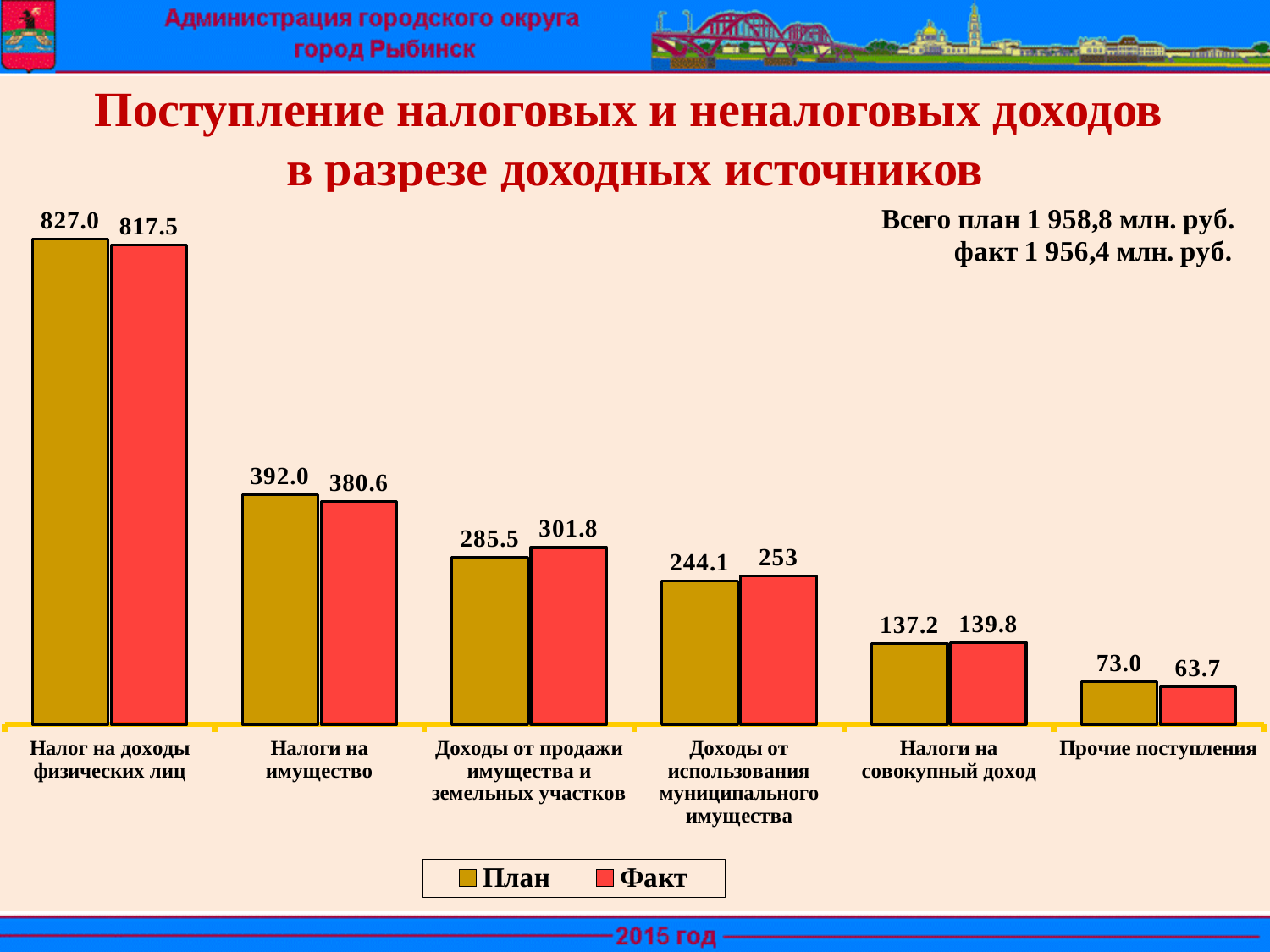
What is the difference between the План and Факт values for Налоги на имущество? 11.4 What is the Факт value for Доходы от продажи имущества и земельных участков? 301.8 What is the Факт value for Прочие поступления? 63.7 How many categories are shown on the x axis? 6 Which category has the highest Факт value? Налог на доходы физических лиц Which is larger for Прочие поступления, План or Факт? План Which category has the lowest План value? Прочие поступления How many series does the legend list? 2 Which colour represents the Факт series in the legend? Red What kind of chart is shown on the slide? Bar chart What is the План value for Налог на доходы физических лиц? 827.0 Which is larger for Доходы от использования муниципального имущества, План or Факт? Факт